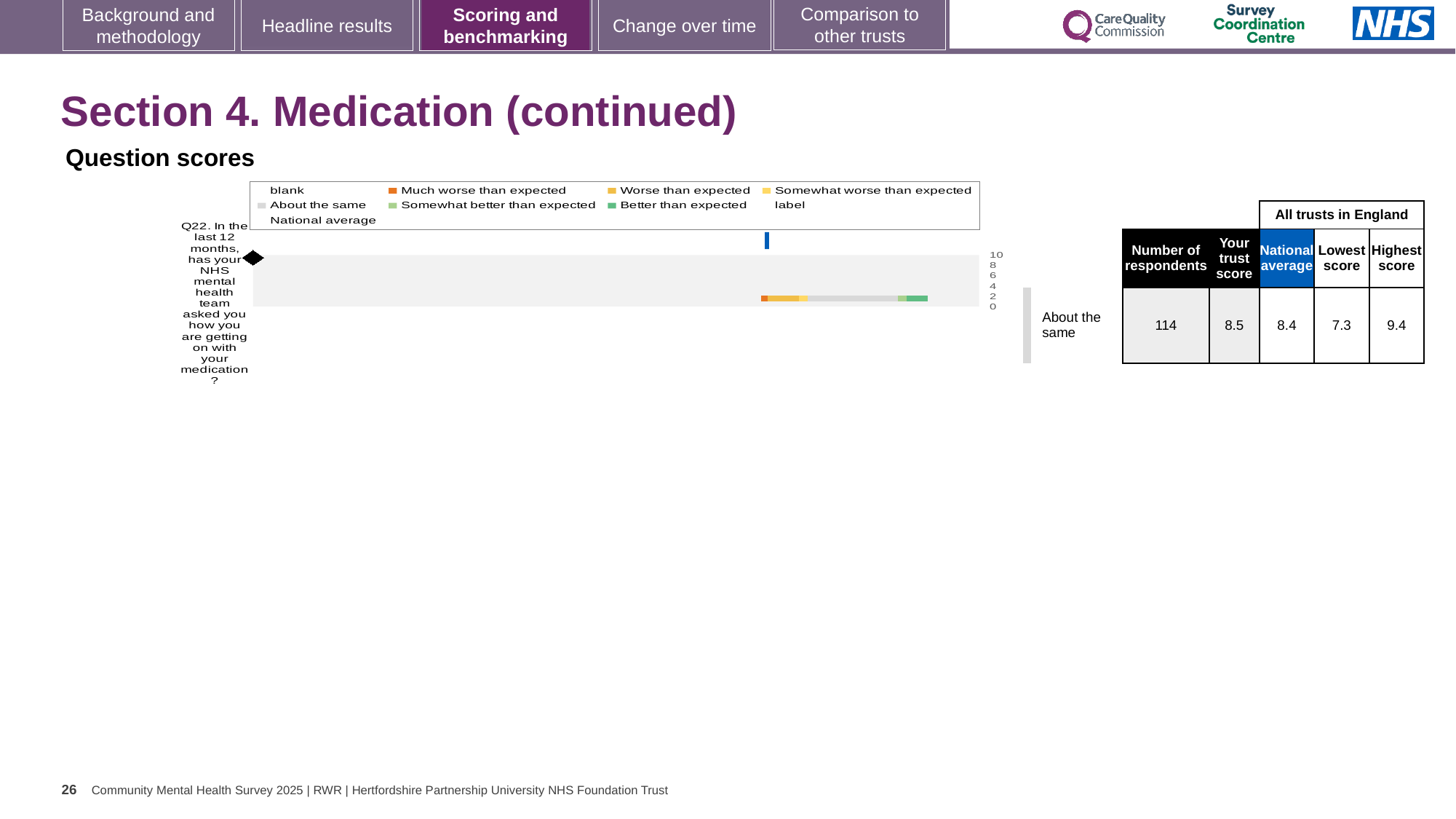
What is the highest score among all trusts in England for Q22? 9.4 What kind of chart is used to show the question scores? Bar chart What is the trust score for Q22 shown in the table next to the chart? 8.5 What benchmark category is the trust's Q22 score placed in? About the same How many respondents answered Q22? 114 What is the difference between the highest score and the lowest score for Q22? 2.1 Which is larger for Q22, the trust score or the national average? Trust score By how much does the trust score for Q22 exceed the national average? 0.1 What is the national average score for Q22? 8.4 What is the lowest score among all trusts in England for Q22? 7.3 What is the highest value shown on the chart's score axis? 10 How many survey questions are plotted on the chart? 1